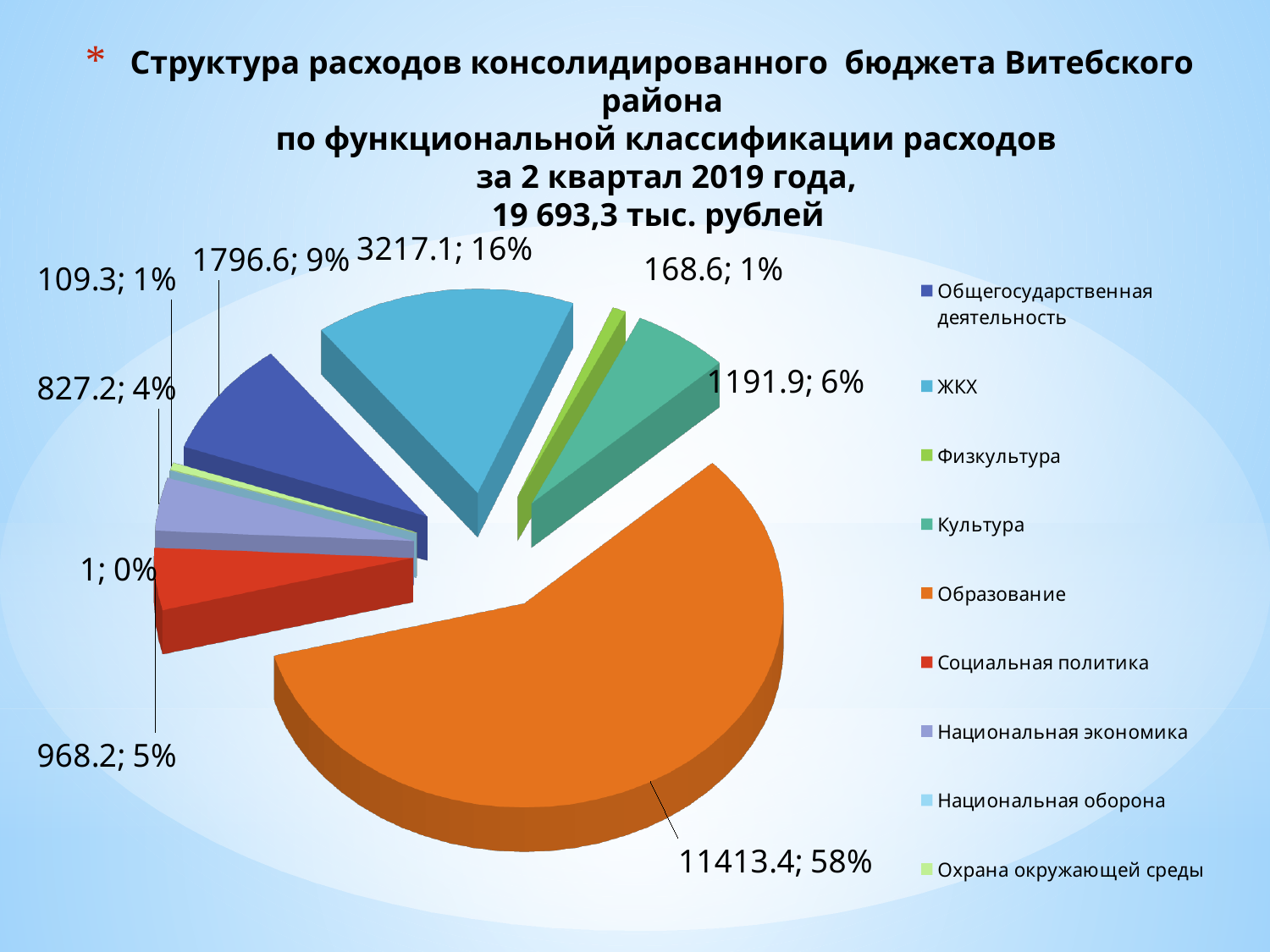
What share of the pie does Культура represent? 6% What share of the pie does Образование represent? 58% What value is shown for Образование? 11413.4 What share of the pie does ЖКХ represent? 16% What value is shown for Общегосударственная деятельность? 1796.6 Which category has the largest slice of the pie? Образование How many categories does the legend of the pie chart list? 9 What is the difference between the values for ЖКХ and Общегосударственная деятельность? 1420.5 What value is shown for ЖКХ? 3217.1 What kind of chart is shown on the slide? pie chart Which category has the smallest slice of the pie? Национальная оборона Which is larger, the value for ЖКХ or the value for Культура? ЖКХ